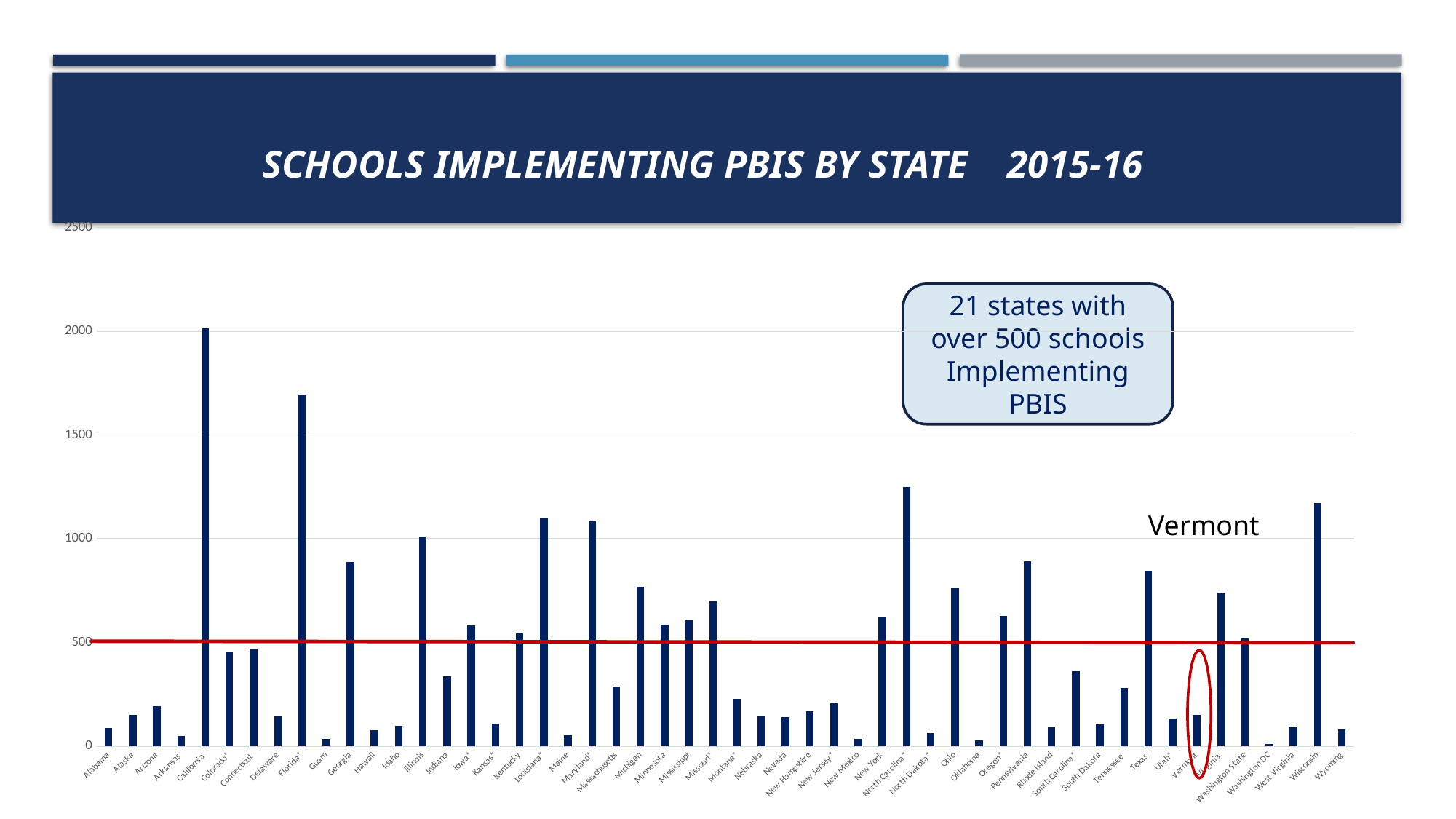
Is the value for North Carolina* greater or less than 1000? greater Is the value for Texas greater or less than 1000? less What is the title of the chart? Schools Implementing PBIS by State 2015-16 Is the value for Florida* greater or less than 1500? greater Which category has the lowest bar on the chart? Washington DC Which has a higher value, California or Florida*? California According to the callout box, how many states have over 500 schools implementing PBIS? 21 Which has a higher value, Michigan or Minnesota? Michigan What kind of chart is shown on the slide? Bar chart Which state has the highest number of schools implementing PBIS? California